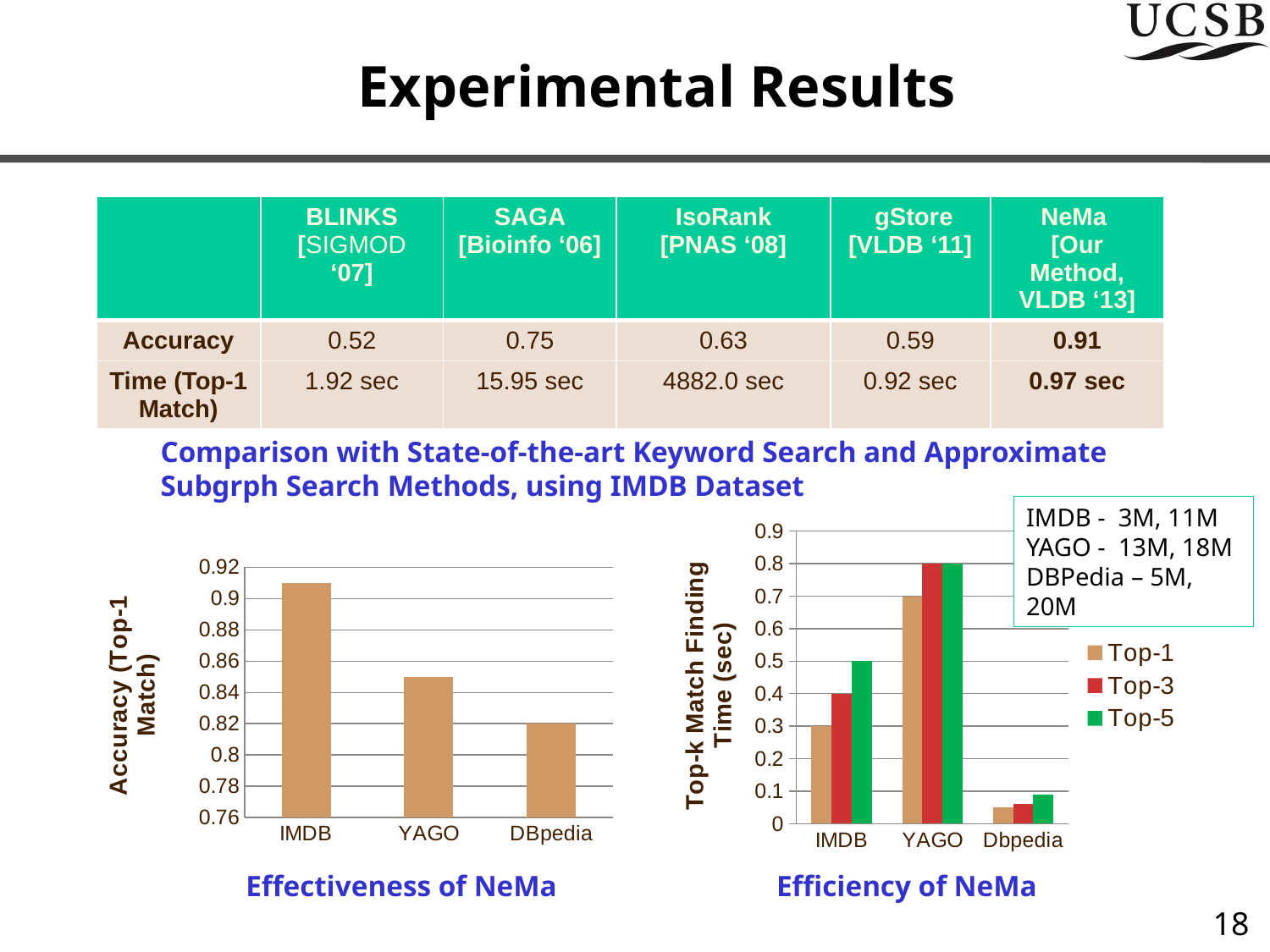
How many series does the legend of the 'Efficiency of NeMa' chart list? 3 In the 'Effectiveness of NeMa' chart, is the accuracy for IMDB greater or less than 0.9? greater In the 'Effectiveness of NeMa' chart, which dataset has the lowest accuracy? DBpedia What kind of chart is the 'Effectiveness of NeMa' chart on the left? bar chart What are the legend entries of the 'Efficiency of NeMa' chart? Top-1, Top-3, Top-5 In the 'Efficiency of NeMa' chart, which dataset has the highest Top-5 match finding time? YAGO In the 'Efficiency of NeMa' chart, which is larger for IMDB: the Top-1 time or the Top-5 time? Top-5 In the 'Effectiveness of NeMa' chart, which dataset has the highest accuracy? IMDB In the 'Effectiveness of NeMa' chart, is the accuracy for YAGO greater or less than 0.86? less In the 'Efficiency of NeMa' chart, is the Top-3 time for YAGO greater or less than 0.7? greater How many datasets are shown on the x axis of the 'Effectiveness of NeMa' chart? 3 In the 'Efficiency of NeMa' chart, which dataset has the lowest Top-1 match finding time? Dbpedia